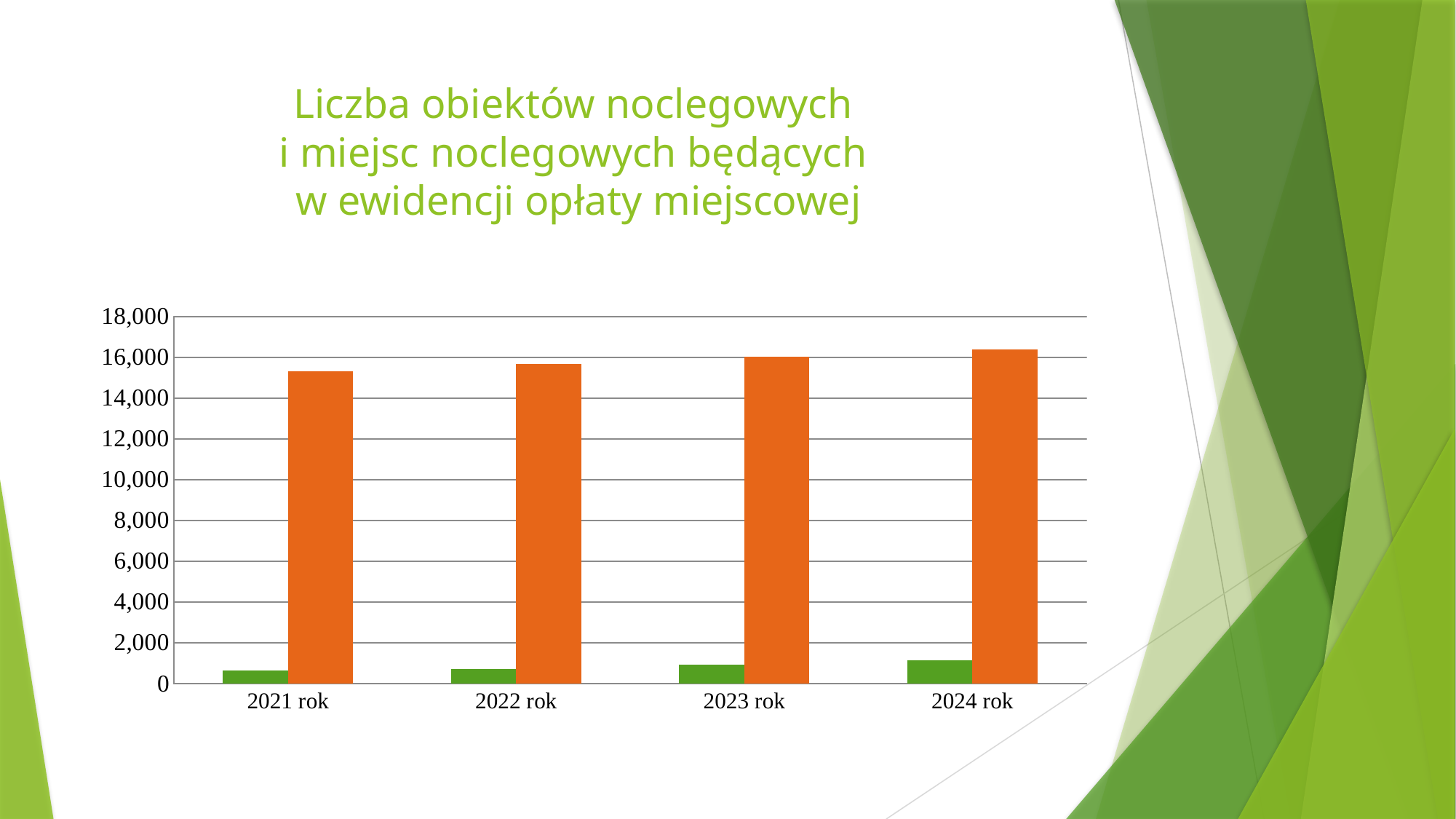
Is the value of the orange bar for 2021 rok greater or less than 16,000? less What kind of chart is shown on the slide? bar chart How many year categories are shown on the x axis of the chart? 4 Is the value of the orange bar for 2022 rok greater or less than 14,000? greater What is the title of the chart on the slide? Liczba obiektów noclegowych i miejsc noclegowych będących w ewidencji opłaty miejscowej Do the orange bars rise or fall from 2021 rok to 2024 rok? rise In which year is the orange bar the highest? 2024 rok How many bars are shown for each year category in the chart? 2 Is the value of the green bar for 2024 rok greater or less than 2,000? less In which year is the orange bar the lowest? 2021 rok Which is larger, the green bar for 2021 rok or the green bar for 2024 rok? 2024 rok